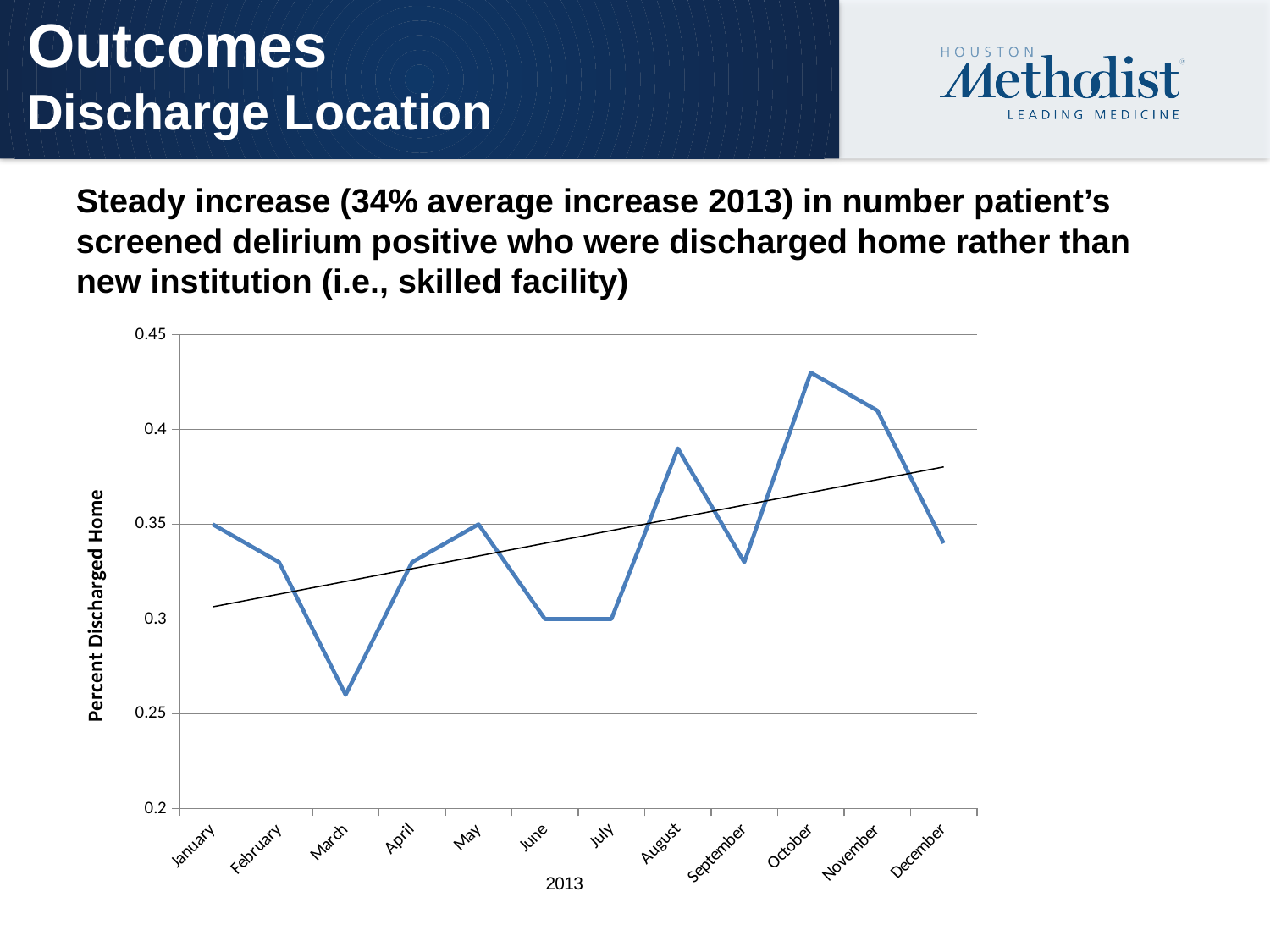
How many months are plotted along the x axis of the chart? 12 Is the value for October greater or less than 0.4? greater What is the percent discharged home value for May? 0.35 Which month has a higher percent discharged home, November or December? November Is the value for March greater or less than 0.3? less Is the value for August greater or less than 0.35? greater What kind of chart is shown on the slide? line chart Which month has the lowest percent discharged home? March What is the title of the y axis of the chart? Percent Discharged Home What is the percent discharged home value for June? 0.3 Which month has the highest percent discharged home? October Does the black trend line rise or fall from January to December? rises